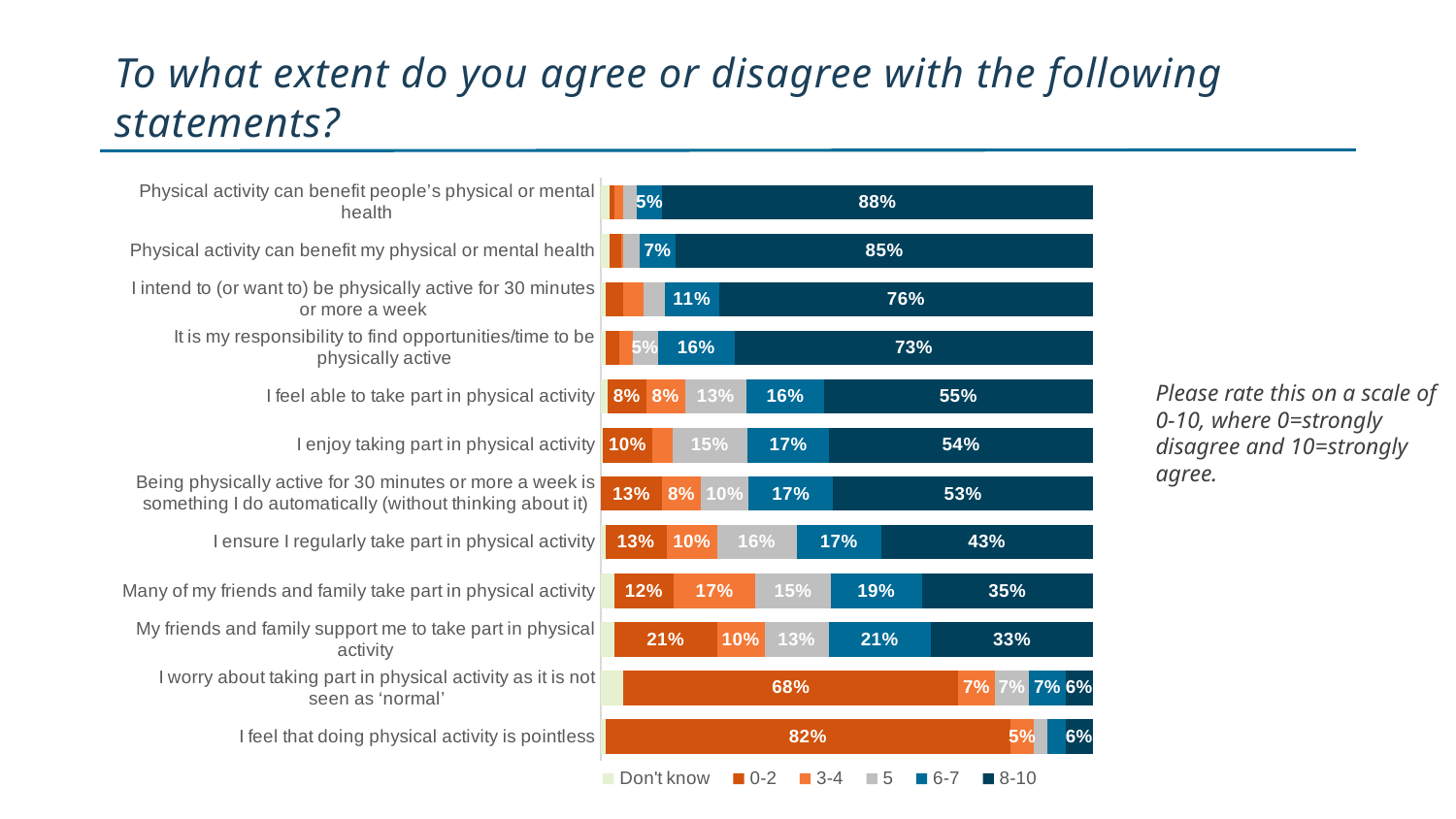
How many statements are shown in the chart? 12 What percentage of respondents rated 0-2 for the statement 'I feel that doing physical activity is pointless'? 82% How many series does the legend list? 6 What percentage of respondents rated 0-2 for the statement 'My friends and family support me to take part in physical activity'? 21% Which statement has the highest percentage of respondents rating 0-2? I feel that doing physical activity is pointless Which statement has a larger 8-10 percentage: 'I ensure I regularly take part in physical activity' or 'Many of my friends and family take part in physical activity'? I ensure I regularly take part in physical activity Which rating category does the darkest blue segment represent according to the legend? 8-10 What percentage of respondents rated 6-7 for the statement 'Many of my friends and family take part in physical activity'? 19% What kind of chart is shown on the slide? Stacked bar chart What percentage of respondents rated 8-10 for the statement 'Physical activity can benefit people's physical or mental health'? 88% Which statement has the highest percentage of respondents rating 8-10? Physical activity can benefit people's physical or mental health What is the difference between the 8-10 percentage for 'Physical activity can benefit people's physical or mental health' and for 'Physical activity can benefit my physical or mental health'? 3%